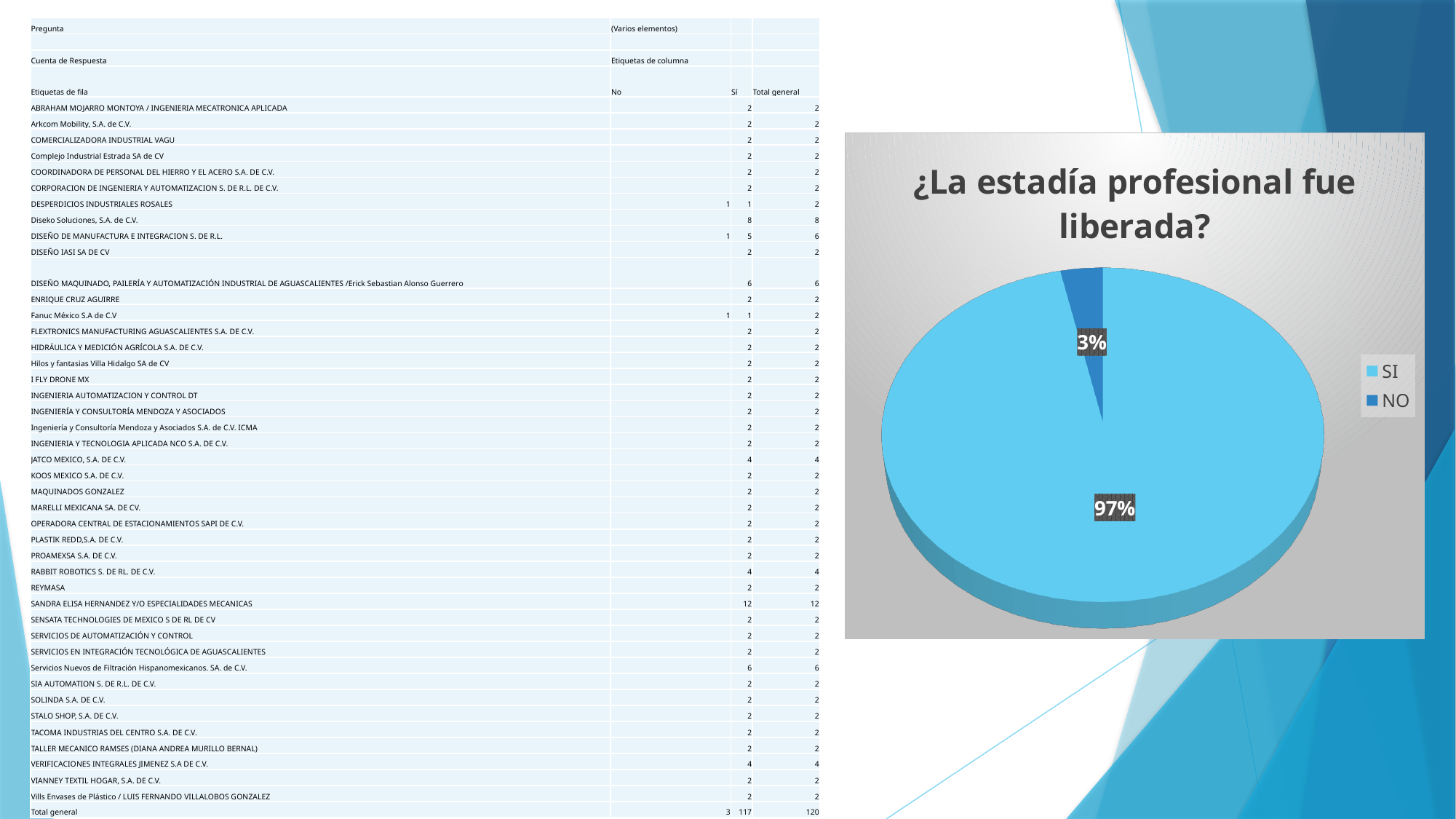
What is the difference in percentage points between the SI and NO slices? 94 Which category has the smallest share of the pie chart? NO How many entries does the legend of the pie chart list? 2 What type of chart is shown on the slide? pie chart How many slices does the pie chart have? 2 What percentage of the pie chart corresponds to SI? 97% Which category has the largest share of the pie chart? SI What colour is the NO slice in the pie chart? dark blue Which slice is larger, SI or NO? SI What is the title of the pie chart? ¿La estadía profesional fue liberada? What percentage of the pie chart corresponds to NO? 3%